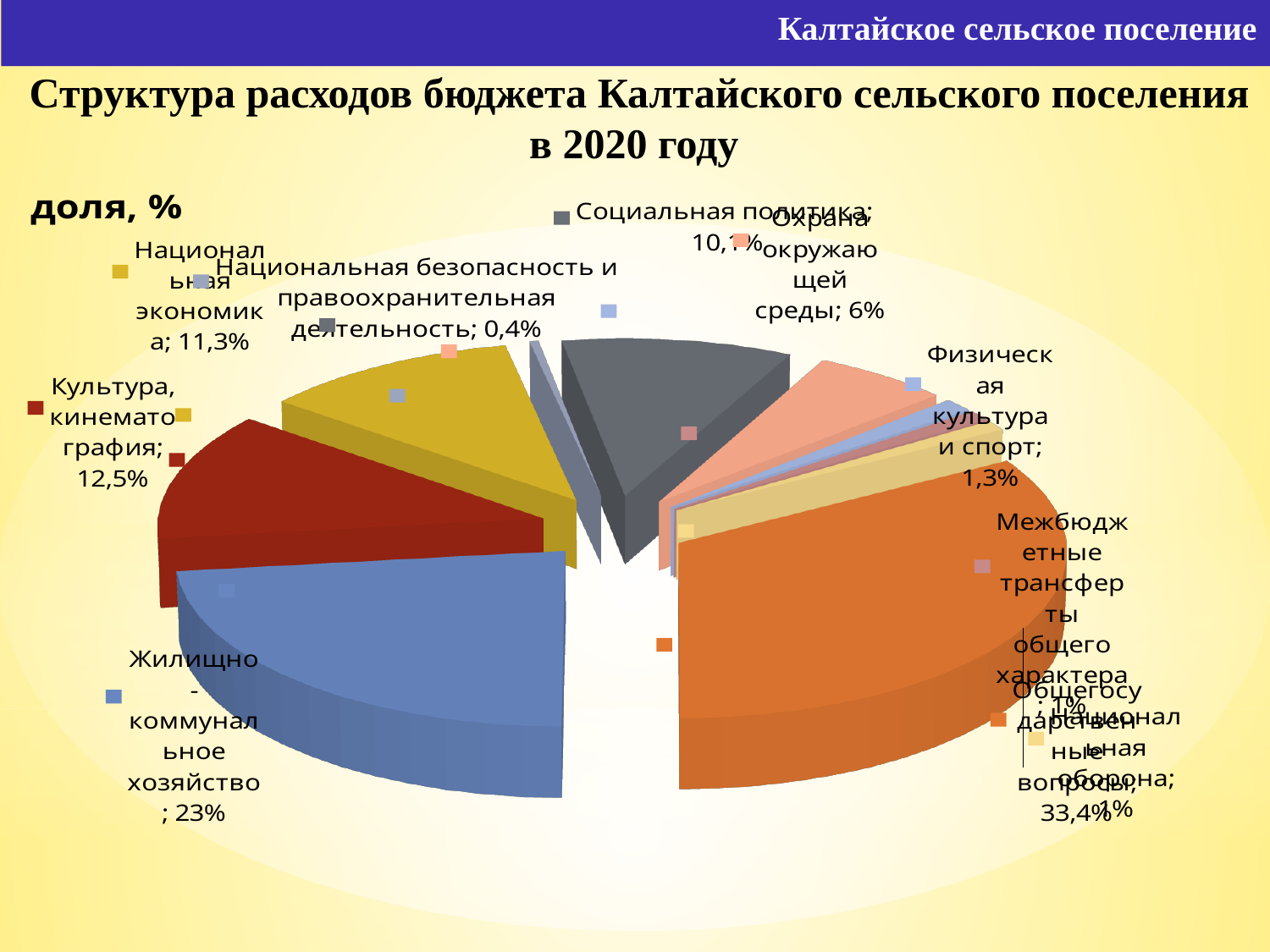
By how many percentage points does Общегосударственные вопросы exceed Жилищно-коммунальное хозяйство? 10,4 What share is shown for Культура, кинематография? 12,5% What share is shown for Жилищно-коммунальное хозяйство? 23% Which category has the smallest share of the budget expenditure? Национальная безопасность и правоохранительная деятельность What share is shown for Охрана окружающей среды? 6% Which category has the largest share of the budget expenditure? Общегосударственные вопросы What share of budget expenditure is Общегосударственные вопросы? 33,4% What share is shown for Национальная экономика? 11,3% Which is larger: the share for Культура, кинематография or for Национальная экономика? Культура, кинематография What is the title of the chart? доля, % What share is shown for Физическая культура и спорт? 1,3% What kind of chart is shown on the slide? Pie chart